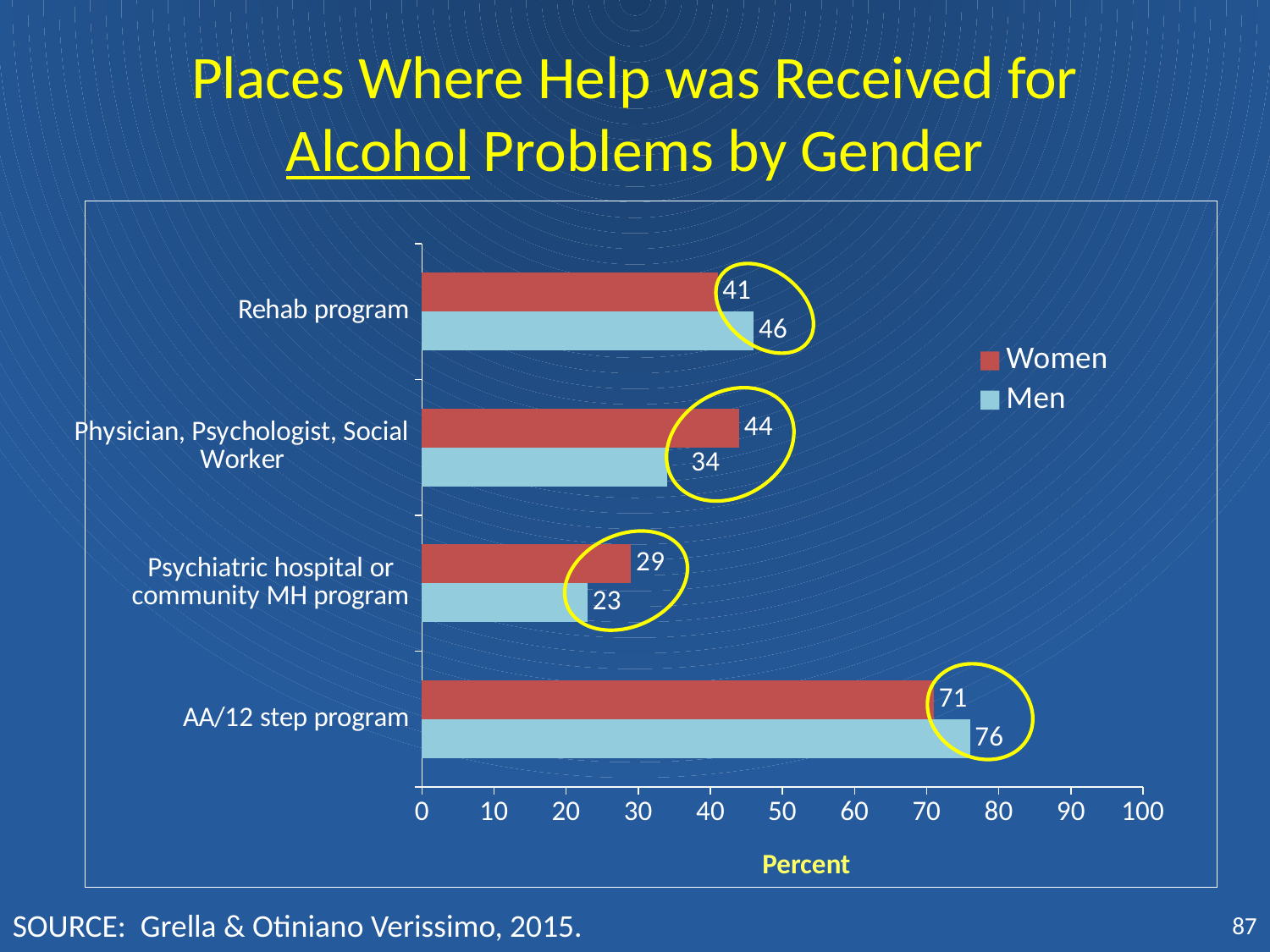
How many series does the legend list? 2 What is the label of the horizontal axis? Percent Which category has the lowest value for Men? Psychiatric hospital or community MH program What is the value for Men for AA/12 step program? 76 What kind of chart is shown on the slide? bar chart What is the value for Women for Rehab program? 41 Which category has the highest value for Women? AA/12 step program Which is larger for Rehab program, the Women value or the Men value? Men How many categories are shown on the chart? 4 Is the value for Women for AA/12 step program greater or less than 60? greater What is the difference between the Women and Men values for Physician, Psychologist, Social Worker? 10 What is the value for Men for Psychiatric hospital or community MH program? 23